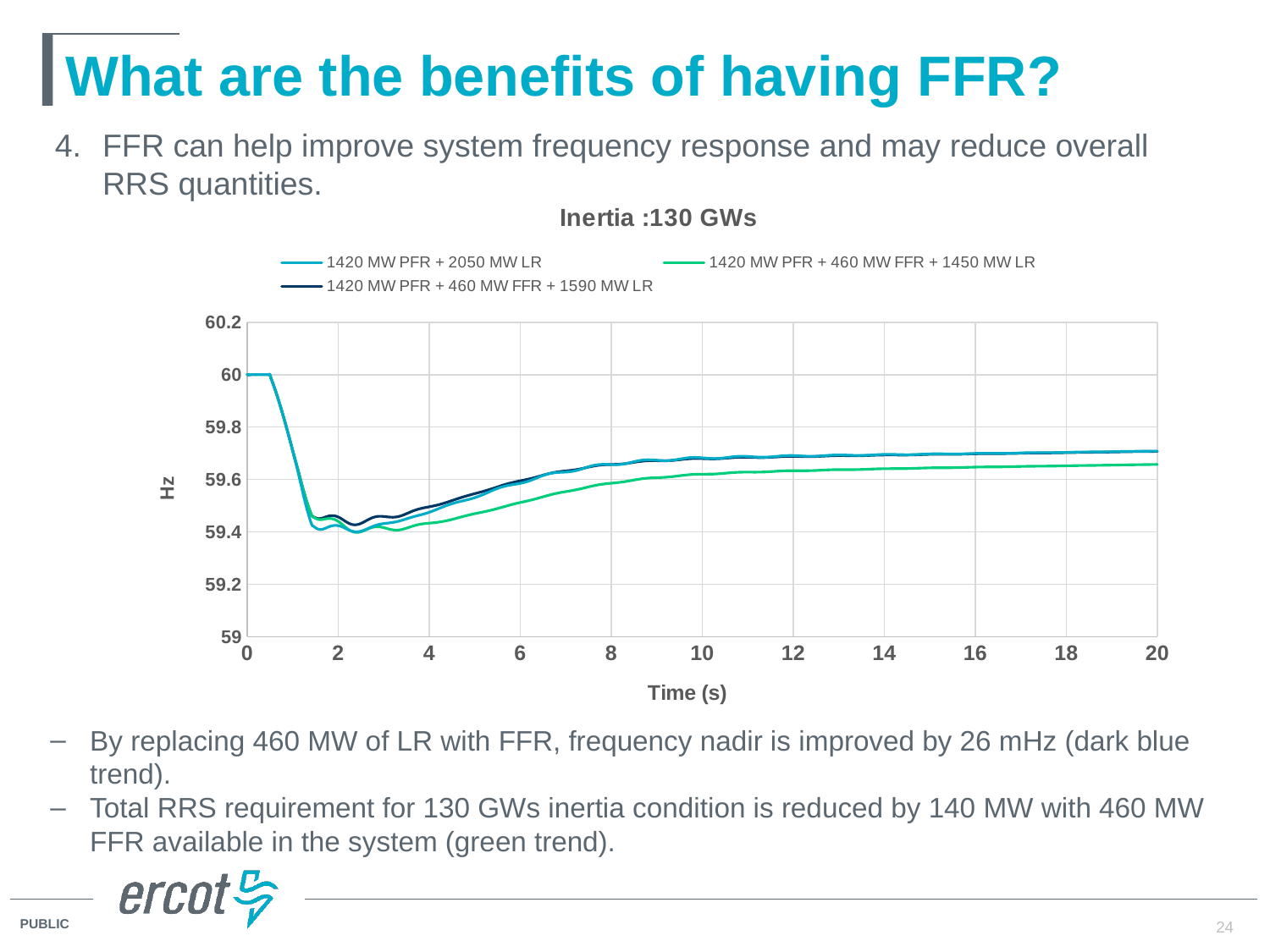
How many series does the legend of the chart list? 3 Is the value of the 1420 MW PFR + 2050 MW LR series at 10 s greater or less than 59.4? greater Is the lowest point of the 1420 MW PFR + 460 MW FFR + 1450 MW LR series greater or less than 59.6? less What is the label of the y axis of the chart? Hz What is the title of the chart? Inertia :130 GWs Between 4 s and 20 s, do the frequency values rise or fall along the x axis? rise What is the highest tick value shown on the y axis? 60.2 Which series has the highest minimum (nadir) frequency? 1420 MW PFR + 460 MW FFR + 1590 MW LR At 20 s, which series has the higher value: 1420 MW PFR + 460 MW FFR + 1590 MW LR or 1420 MW PFR + 460 MW FFR + 1450 MW LR? 1420 MW PFR + 460 MW FFR + 1590 MW LR Is the value of the 1420 MW PFR + 460 MW FFR + 1450 MW LR series at 20 s greater or less than 59.8? less What kind of chart is shown on the slide? line chart What is the frequency value of all three series at time 0 s? 60